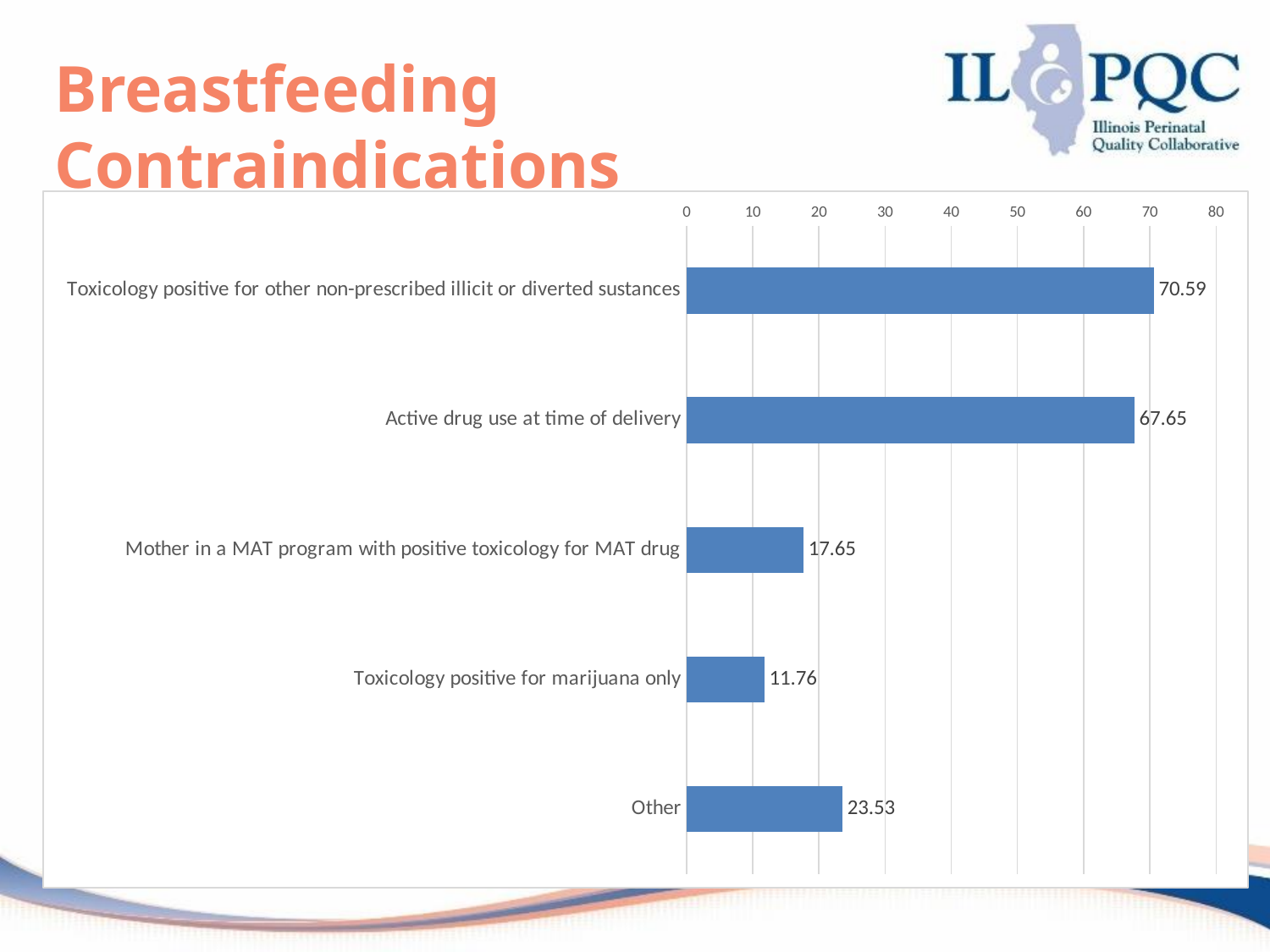
What is the value for "Toxicology positive for marijuana only"? 11.76 Which category has the highest value? Toxicology positive for other non-prescribed illicit or diverted sustances What is the value for "Other"? 23.53 What is the value for "Active drug use at time of delivery"? 67.65 What is the difference between the values for "Other" and "Toxicology positive for marijuana only"? 11.77 Which is larger, the value for "Other" or the value for "Mother in a MAT program with positive toxicology for MAT drug"? Other How many categories are shown in the chart? 5 Is the value for "Active drug use at time of delivery" greater or less than 60? greater What kind of chart is shown on the slide? Bar chart Which category has the lowest value? Toxicology positive for marijuana only What is the value for "Mother in a MAT program with positive toxicology for MAT drug"? 17.65 What is the difference between the values for "Toxicology positive for other non-prescribed illicit or diverted sustances" and "Active drug use at time of delivery"? 2.94